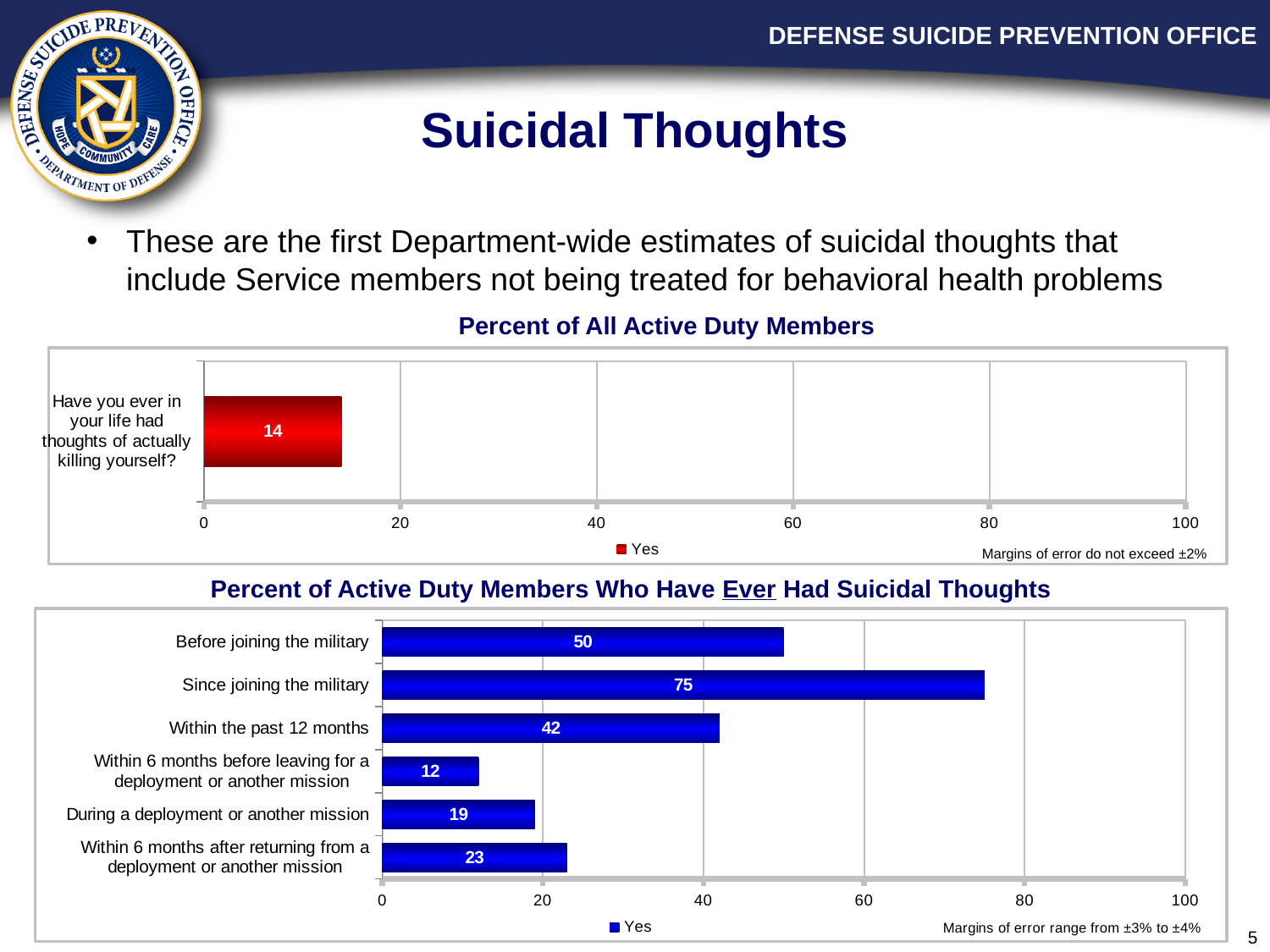
In the 'Percent of Active Duty Members Who Have Ever Had Suicidal Thoughts' chart, how many categories are shown? 6 In the 'Percent of All Active Duty Members' chart, how many series does the legend list? 1 In the 'Percent of Active Duty Members Who Have Ever Had Suicidal Thoughts' chart, what is the difference between 'Since joining the military' and 'Before joining the military'? 25 In the 'Percent of Active Duty Members Who Have Ever Had Suicidal Thoughts' chart, what is the value for 'Before joining the military'? 50 In the 'Percent of Active Duty Members Who Have Ever Had Suicidal Thoughts' chart, which category has the lowest value? Within 6 months before leaving for a deployment or another mission In the 'Percent of Active Duty Members Who Have Ever Had Suicidal Thoughts' chart, what is the value for 'Since joining the military'? 75 In the 'Percent of All Active Duty Members' chart, what is the value for 'Have you ever in your life had thoughts of actually killing yourself?' 14 In the 'Percent of Active Duty Members Who Have Ever Had Suicidal Thoughts' chart, which category has the highest value? Since joining the military In the 'Percent of All Active Duty Members' chart, what is the legend entry? Yes In the 'Percent of All Active Duty Members' chart, what kind of chart is shown? bar chart In the 'Percent of Active Duty Members Who Have Ever Had Suicidal Thoughts' chart, what is the value for 'Within the past 12 months'? 42 In the 'Percent of Active Duty Members Who Have Ever Had Suicidal Thoughts' chart, which is larger: 'During a deployment or another mission' or 'Within 6 months after returning from a deployment or another mission'? Within 6 months after returning from a deployment or another mission